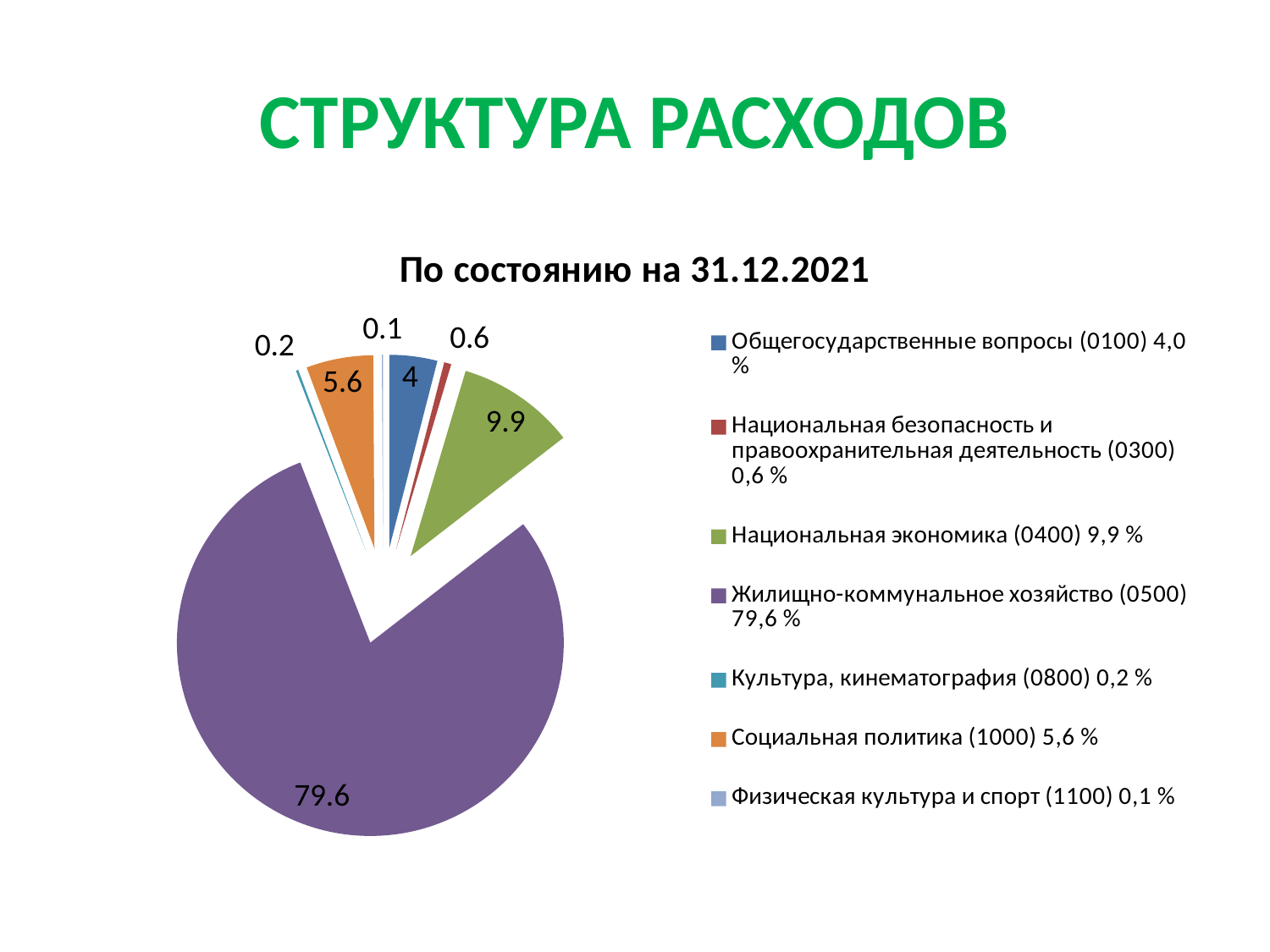
How many slices does the pie chart have? 7 What is the difference between the values for Национальная экономика (0400) and Социальная политика (1000)? 4.3 What is the data label on the slice for Общегосударственные вопросы (0100)? 4 Which is larger: the slice for Общегосударственные вопросы (0100) or the slice for Социальная политика (1000)? Социальная политика (1000) What kind of chart is shown on the slide? pie chart What is the data label on the slice for Жилищно-коммунальное хозяйство (0500)? 79.6 What is the title of the chart? По состоянию на 31.12.2021 What colour is the slice for Национальная экономика (0400)? green Which category has the smallest slice of the pie? Физическая культура и спорт (1100) Which category has the largest slice of the pie? Жилищно-коммунальное хозяйство (0500) What is the data label on the slice for Национальная экономика (0400)? 9.9 What is the data label on the slice for Социальная политика (1000)? 5.6